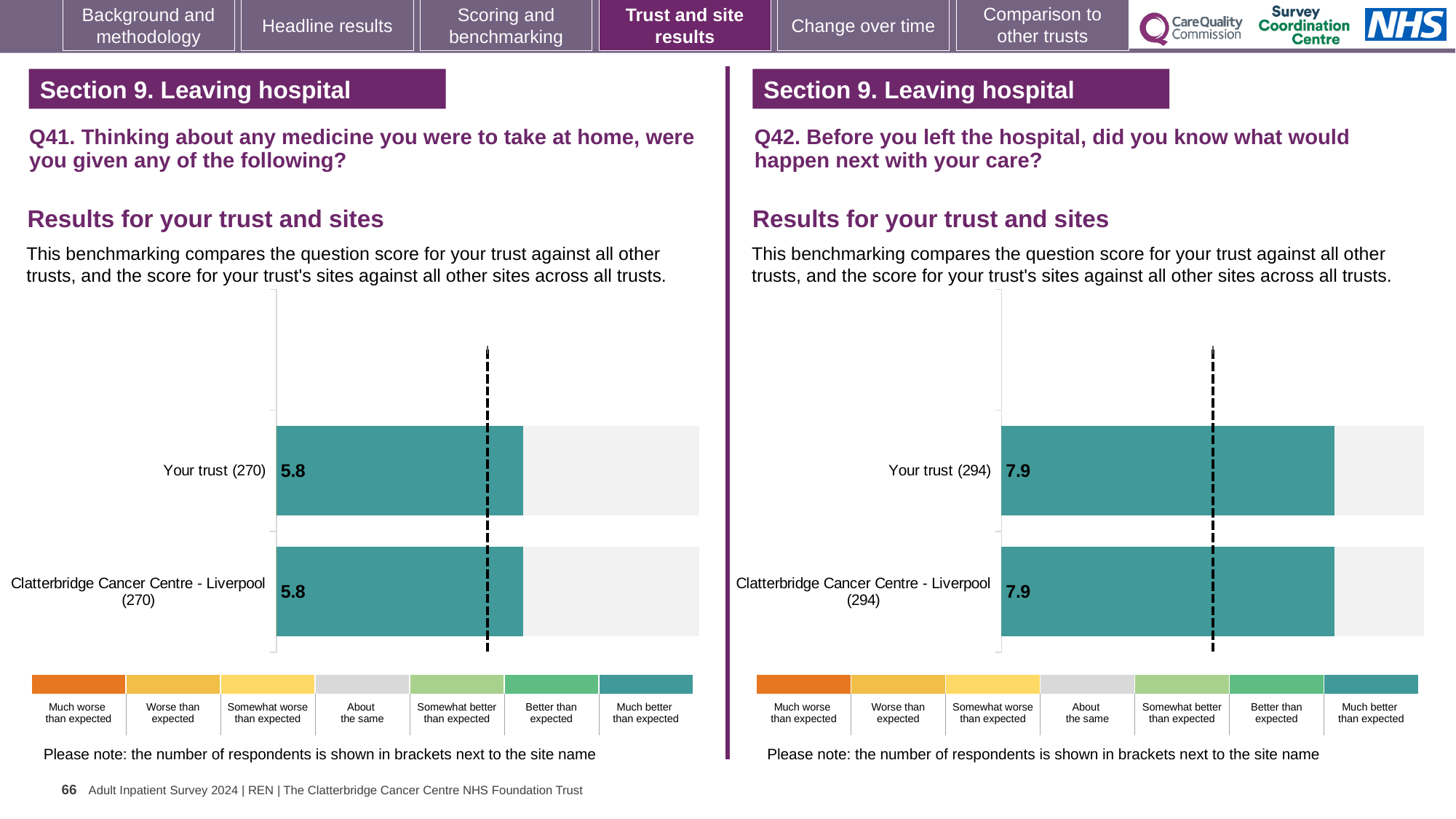
How many categories does the colour key below the Q42 chart on the right list? 7 In the Q42 chart on the right, how many respondents are shown in brackets for Clatterbridge Cancer Centre - Liverpool? 294 In the Q42 chart on the right, how many bars are plotted? 2 In the Q41 chart on the left, what is the score for Your trust? 5.8 In the Q42 chart on the right, what is the score for Clatterbridge Cancer Centre - Liverpool? 7.9 In the Q41 chart on the left, what is the difference between the score for Your trust and the score for Clatterbridge Cancer Centre - Liverpool? 0 In the Q41 chart on the left, which category of the colour key does the teal colour of the bars correspond to? Much better than expected In the Q41 chart on the left, what is the score for Clatterbridge Cancer Centre - Liverpool? 5.8 In the Q41 chart on the left, how many respondents are shown in brackets for Your trust? 270 In the Q42 chart on the right, what is the score for Your trust? 7.9 What kind of chart is the Q41 chart on the left? Bar chart Is the score for Your trust in the Q42 chart on the right larger or smaller than the score for Your trust in the Q41 chart on the left? Larger